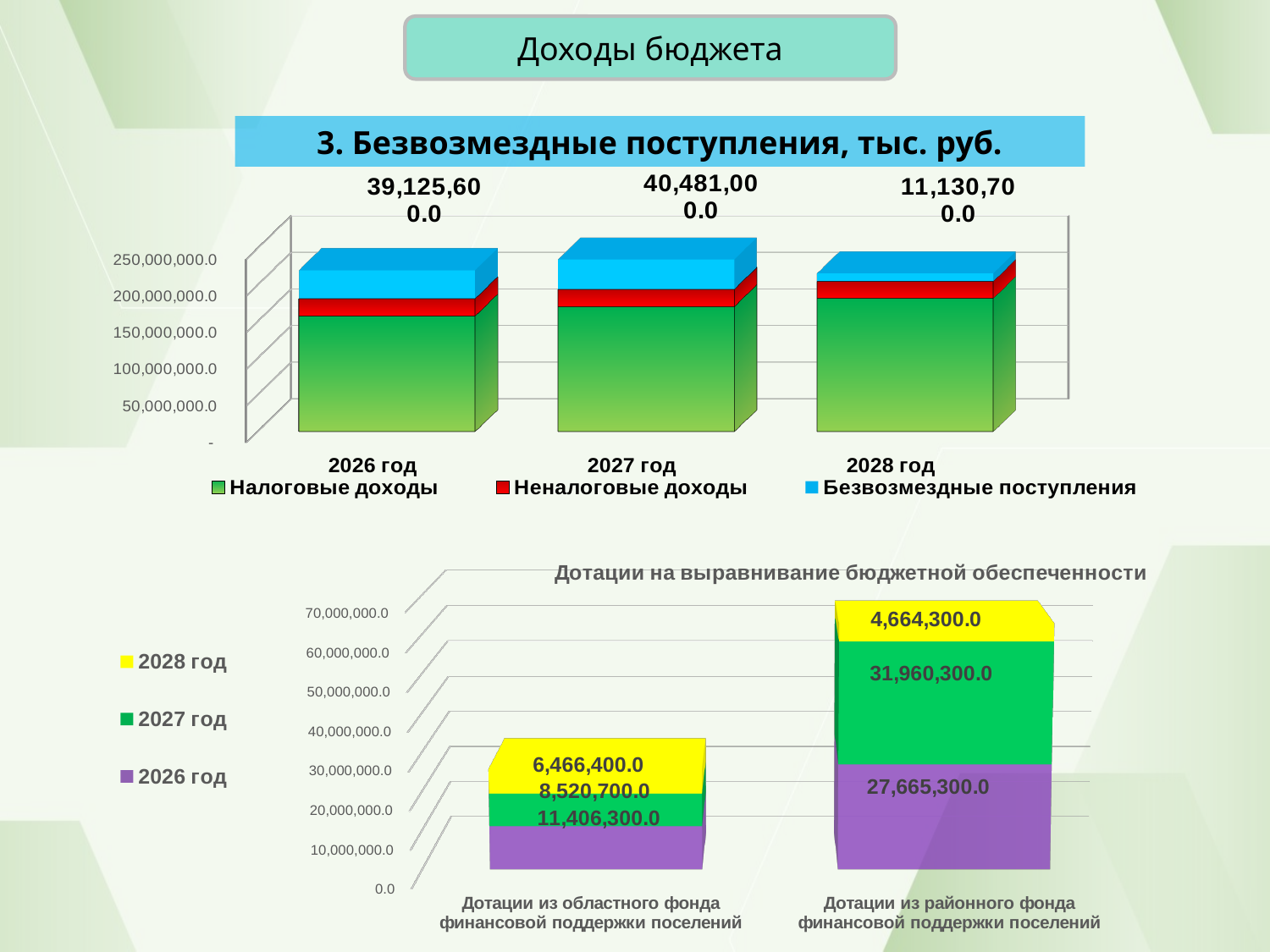
In the bottom chart (Дотации на выравнивание бюджетной обеспеченности), what is the value for 2027 год for Дотации из районного фонда финансовой поддержки поселений? 31,960,300.0 In the bottom chart (Дотации на выравнивание бюджетной обеспеченности), how many series does the legend list? 3 In the top chart (3. Безвозмездные поступления, тыс. руб.), what value is printed above the 2027 год bar? 40,481,000.0 In the bottom chart (Дотации на выравнивание бюджетной обеспеченности), what is the difference between the 2027 год and 2026 год values for Дотации из районного фонда финансовой поддержки поселений? 4,295,000.0 In the bottom chart (Дотации на выравнивание бюджетной обеспеченности), how many categories are shown on the x axis? 2 In the bottom chart (Дотации на выравнивание бюджетной обеспеченности), what is the value for 2026 год for Дотации из районного фонда финансовой поддержки поселений? 27,665,300.0 In the bottom chart (Дотации на выравнивание бюджетной обеспеченности), which is larger for Дотации из областного фонда финансовой поддержки поселений: the 2026 год value or the 2027 год value? 2026 год What kind of chart is the top chart titled '3. Безвозмездные поступления, тыс. руб.'? Stacked bar chart In the top chart (3. Безвозмездные поступления, тыс. руб.), which series is shown in red in the legend? Неналоговые доходы In the bottom chart (Дотации на выравнивание бюджетной обеспеченности), what is the total of the stacked bar for Дотации из районного фонда финансовой поддержки поселений? 64,289,900.0 In the bottom chart (Дотации на выравнивание бюджетной обеспеченности), what is the total of the stacked bar for Дотации из областного фонда финансовой поддержки поселений? 26,393,400.0 In the bottom chart (Дотации на выравнивание бюджетной обеспеченности), what is the value for 2028 год for Дотации из областного фонда финансовой поддержки поселений? 6,466,400.0